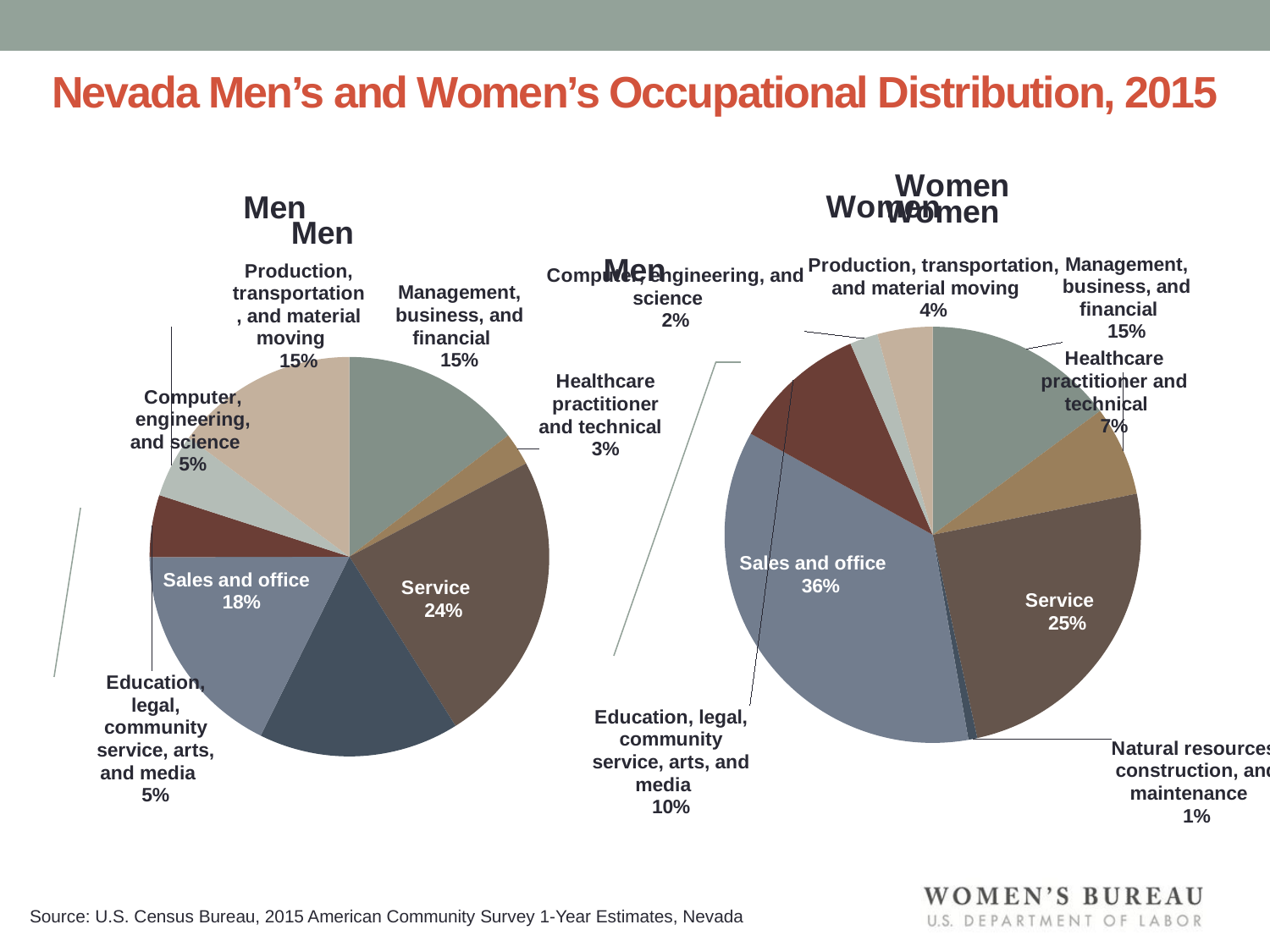
In the Men pie chart, which labeled occupation has the largest share? Service In the Men pie chart, what share is Service? 24% In the Women pie chart, which occupation has the largest share? Sales and office Which is larger: the Education, legal, community service, arts, and media share for Women or for Men? Women How many pie charts are on the slide? 2 What type of charts are shown on the slide? Pie charts What is the difference between the Sales and office share in the Women pie chart and in the Men pie chart? 18% In the Men pie chart, what share is Sales and office? 18% In the Women pie chart, what share is Natural resources, construction, and maintenance? 1% In the Women pie chart, what share is Sales and office? 36% What is the difference between the Production, transportation, and material moving share for Men and for Women? 11% In the Women pie chart, what share is Healthcare practitioner and technical? 7%